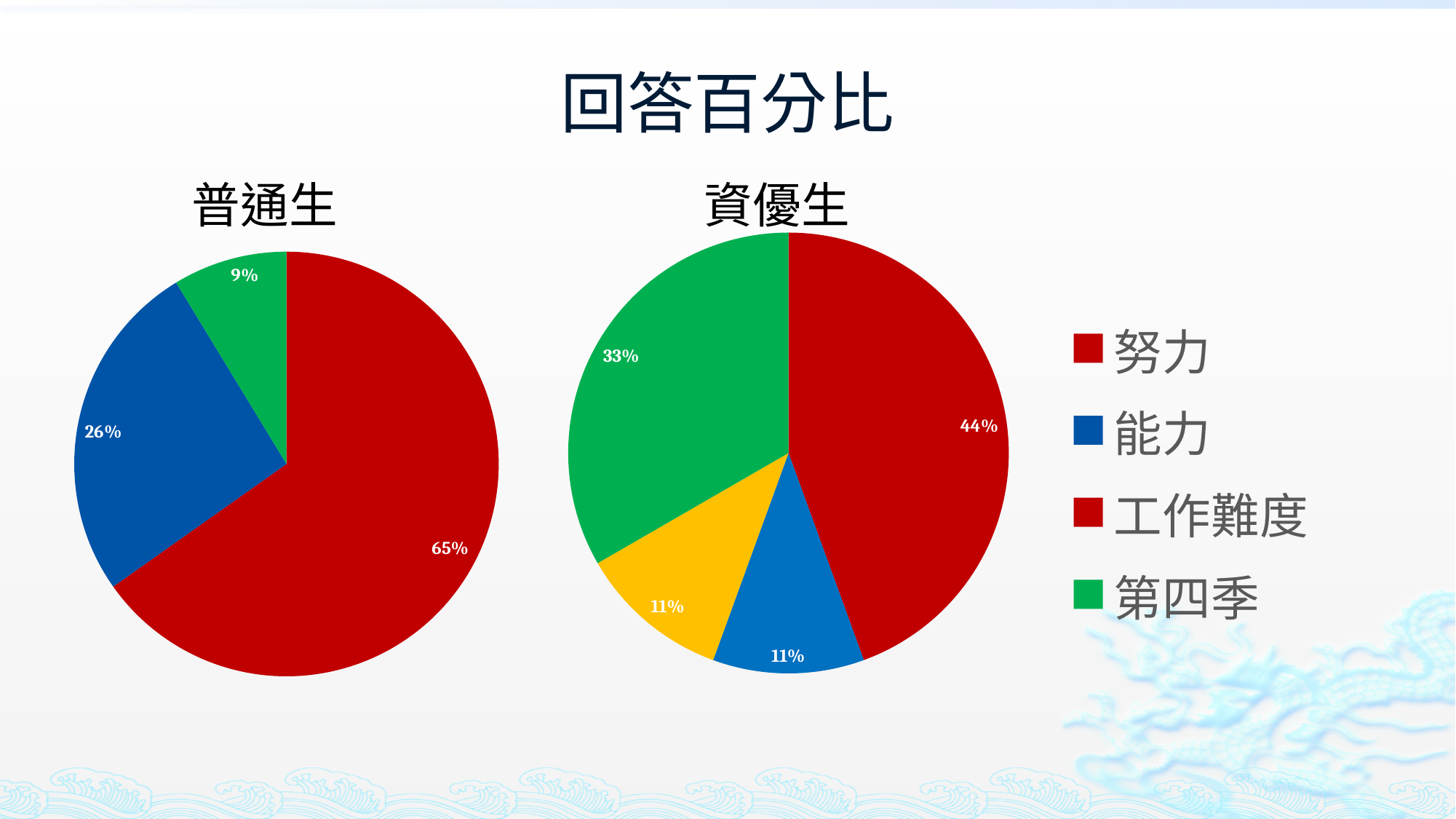
In the 普通生 pie chart, what percentage is shown for 第四季? 9% In the 資優生 pie chart, what percentage is shown for 努力? 44% In the 普通生 pie chart, what percentage is shown for 努力? 65% In the 普通生 pie chart, how many percentage points larger is 努力 than 能力? 39% What kind of chart is used for 普通生 and 資優生? Pie chart How many entries does the legend list? 4 In the 普通生 pie chart, which category has the smallest slice? 第四季 In the 普通生 pie chart, what percentage is shown for 能力? 26% In the 資優生 pie chart, what percentage is shown for 能力? 11% In the 普通生 pie chart, which category has the largest slice? 努力 Which chart shows a larger share for 努力, 普通生 or 資優生? 普通生